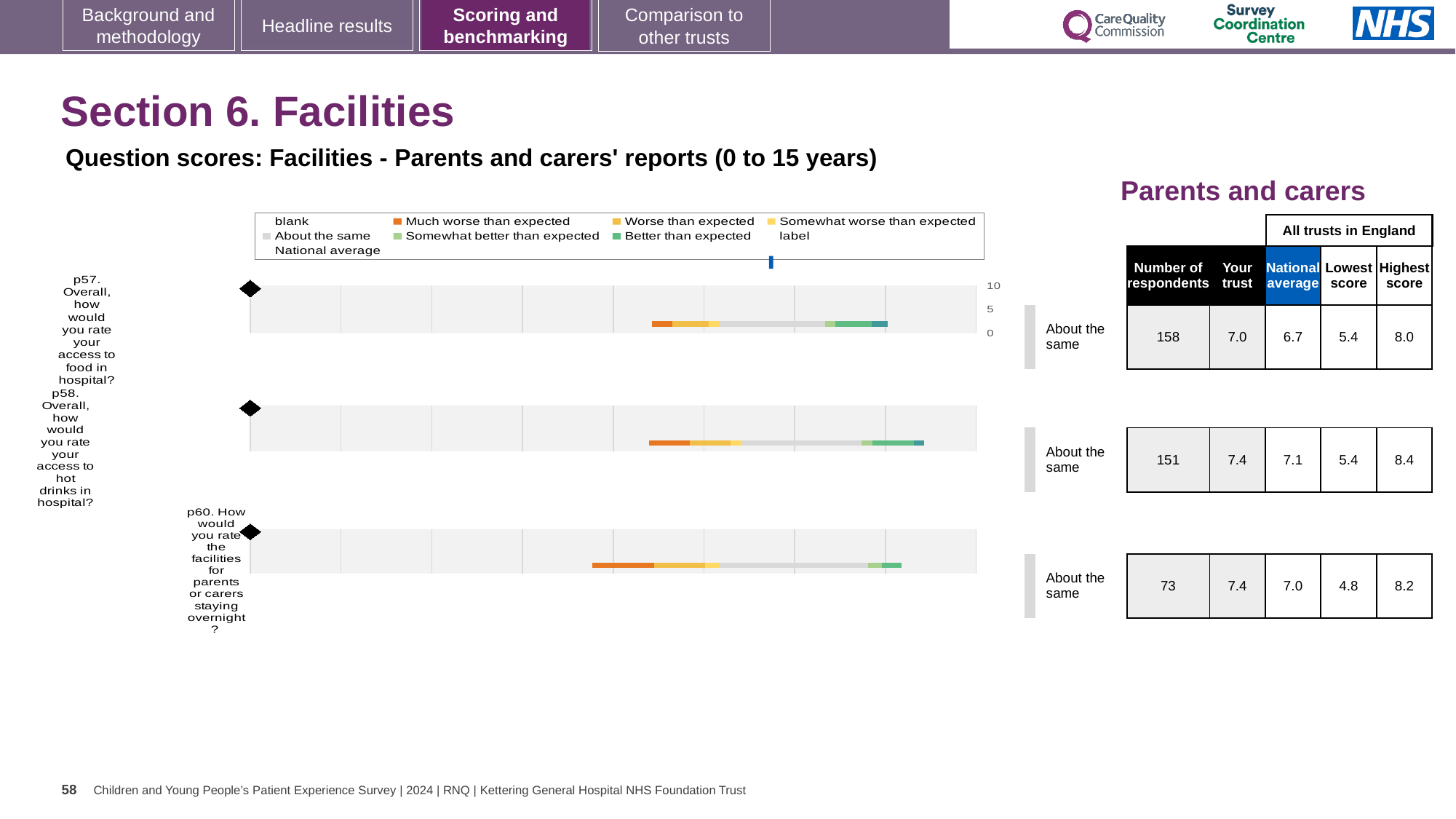
What is the maximum value shown on the chart's score axis? 10 What kind of chart is used to show the question scores for Facilities? bar chart How many respondents answered p60 (facilities for parents or carers staying overnight)? 73 What is the highest score across all trusts in England for p57? 8.0 What is the national average score for p58 (access to hot drinks in hospital)? 7.1 How many questions are plotted in the Facilities question scores chart? 3 For p58, which is larger: the 'Your trust' score or the national average? Your trust What benchmark category is shown next to each of the three questions in the chart? About the same What is the 'Your trust' score for p57 (access to food in hospital)? 7.0 Which question has the lowest 'Lowest score' across all trusts in England? p60 Which question has the highest 'Highest score' across all trusts in England? p58 For p57, what is the difference between the 'Your trust' score and the national average? 0.3